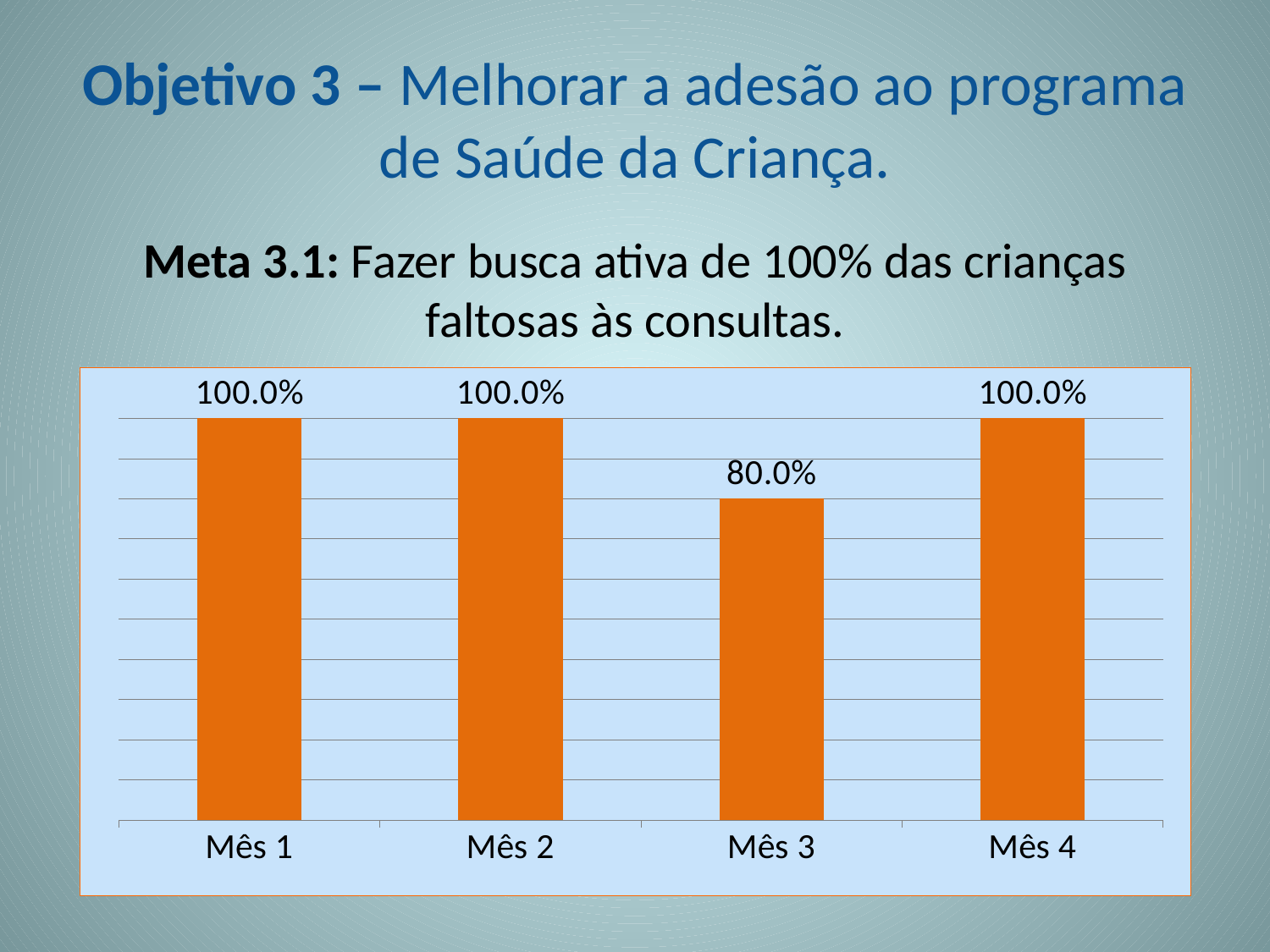
What is the label of the third category on the x axis? Mês 3 How many months have a value of 100.0%? 3 Do the values rise or fall from Mês 2 to Mês 3? Fall What is the difference between the values for Mês 2 and Mês 3? 20.0% What kind of chart is shown on the slide? Bar chart How many months are shown on the x axis? 4 Which is larger, the value for Mês 3 or the value for Mês 4? Mês 4 What colour are the bars in the chart? Orange What is the value for Mês 4? 100.0% What is the value for Mês 1? 100.0% Which month has the lowest value? Mês 3 What is the value for Mês 3? 80.0%